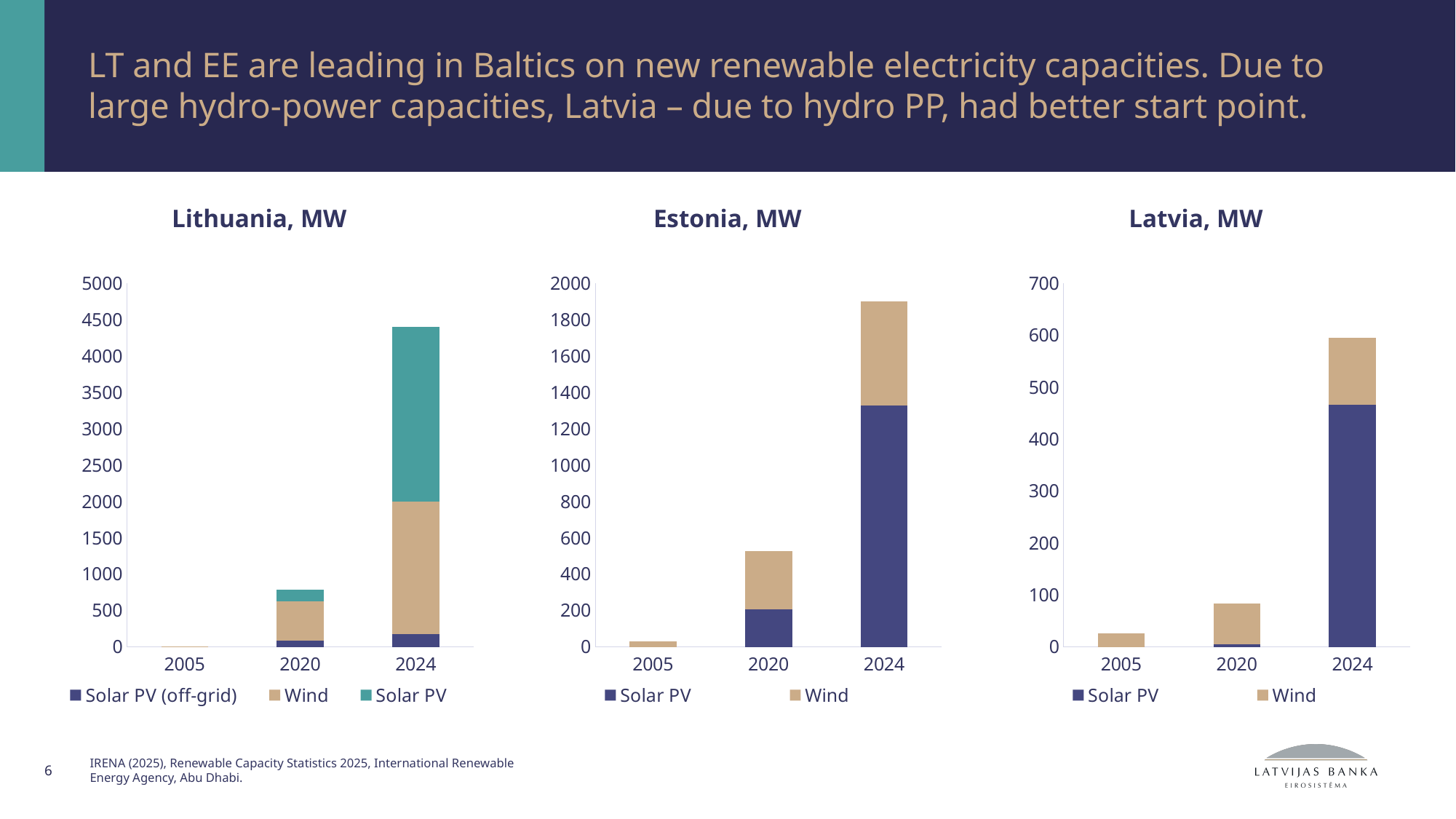
In the Estonia, MW chart, is the total for 2024 greater or less than 1800? greater In the Estonia, MW chart, which series is shown in the darker blue colour? Solar PV How many series does the legend of the Lithuania, MW chart list? 3 How many series does the legend of the Estonia, MW chart list? 2 How many years are shown on the x axis of the Latvia, MW chart? 3 In the Latvia, MW chart, do total capacities rise or fall from 2005 to 2024? rise In the Lithuania, MW chart, which year has the highest total capacity? 2024 What kind of chart is the Lithuania, MW chart? stacked bar chart In the Estonia, MW chart, which year has the lowest total capacity? 2005 In the Latvia, MW chart, is the total for 2024 greater or less than 500? greater In the Lithuania, MW chart, is the total for 2024 greater or less than 4000? greater